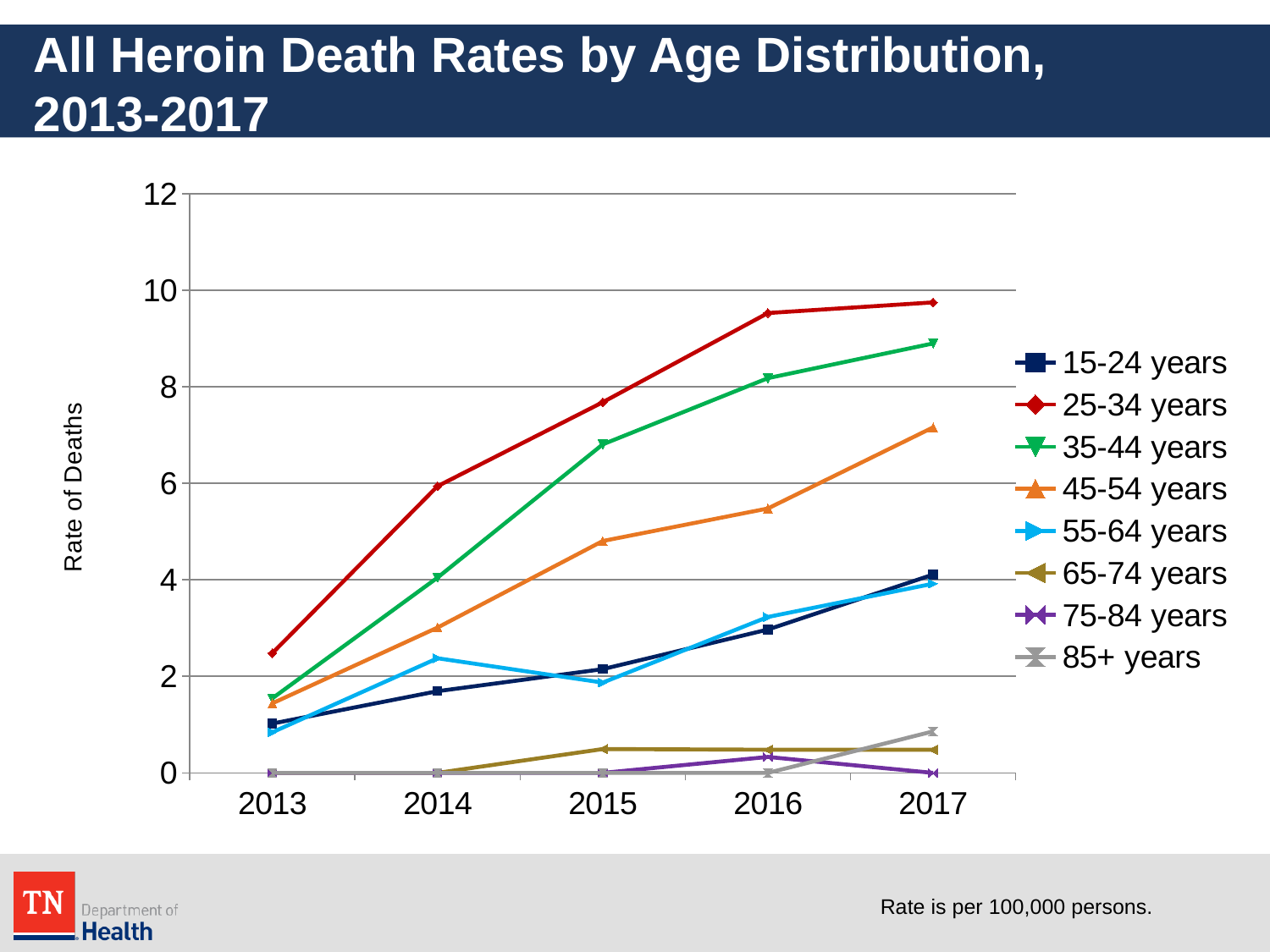
How many years are shown along the x axis? 5 Which age group has the highest heroin death rate in 2017? 25-34 years In 2016, which is larger: the rate for 35-44 years or the rate for 45-54 years? 35-44 years Is the value for 25-34 years in 2017 greater or less than 8? greater Does the rate for 25-34 years rise or fall from 2013 to 2017? rise What kind of chart is shown on the slide? line chart Is the value for 45-54 years in 2017 greater or less than 6? greater How many series does the legend list? 8 According to the note on the slide, the rate is per how many persons? 100,000 persons Is the value for 15-24 years in 2013 greater or less than 2? less Which age group has the lowest heroin death rate in 2017? 75-84 years What is the y-axis title of the chart? Rate of Deaths